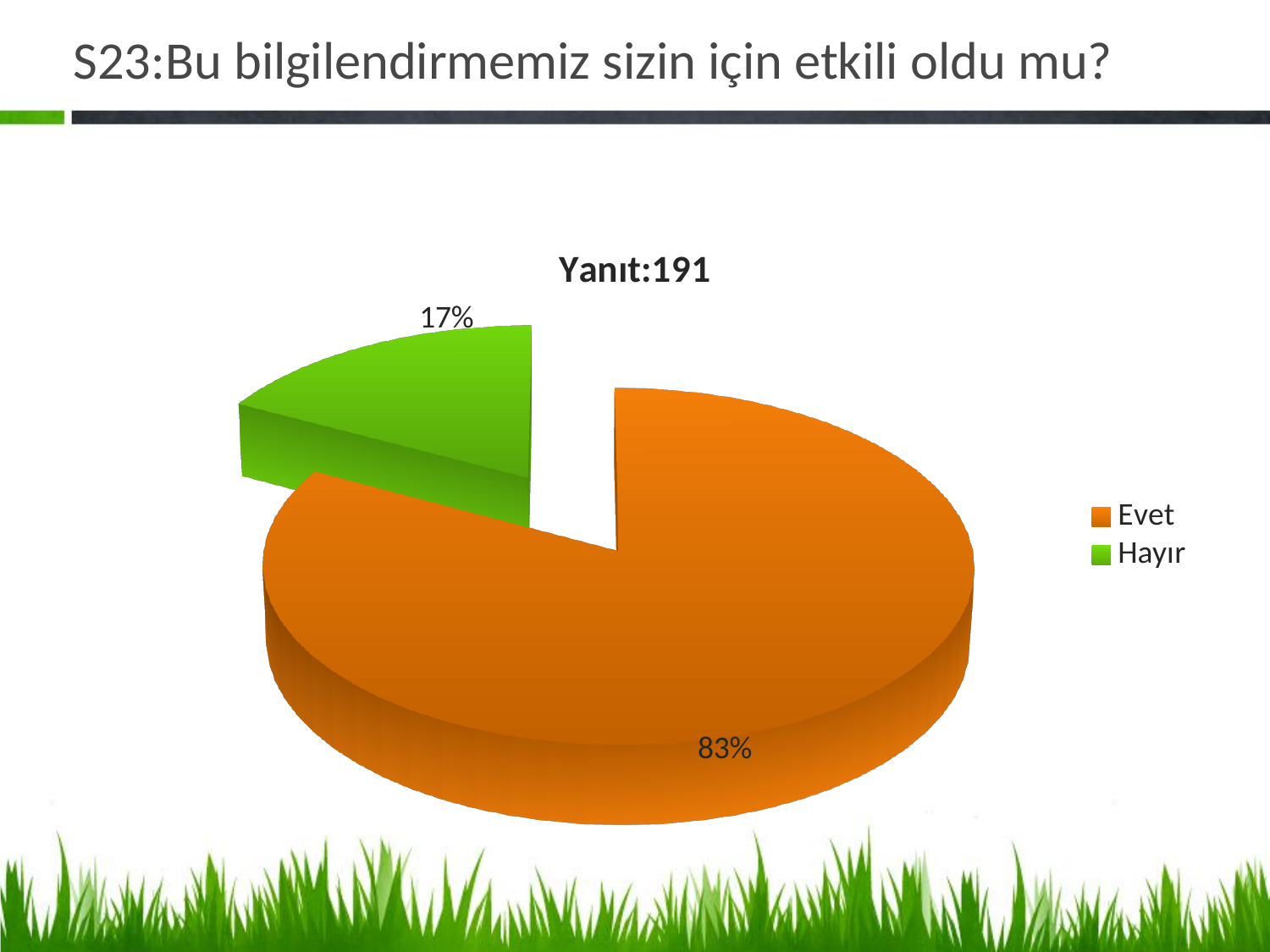
What is the title of the chart? Yanıt:191 What colour is the Hayır slice? green What is the difference in percentage points between the Evet and Hayır slices? 66 How many categories does the pie chart show? 2 What share of the pie does Hayır represent? 17% What share of the pie does Evet represent? 83% Which category has the largest slice of the pie? Evet What kind of chart is shown on the slide? pie chart Which category has the smallest slice of the pie? Hayır Which slice is larger, Evet or Hayır? Evet